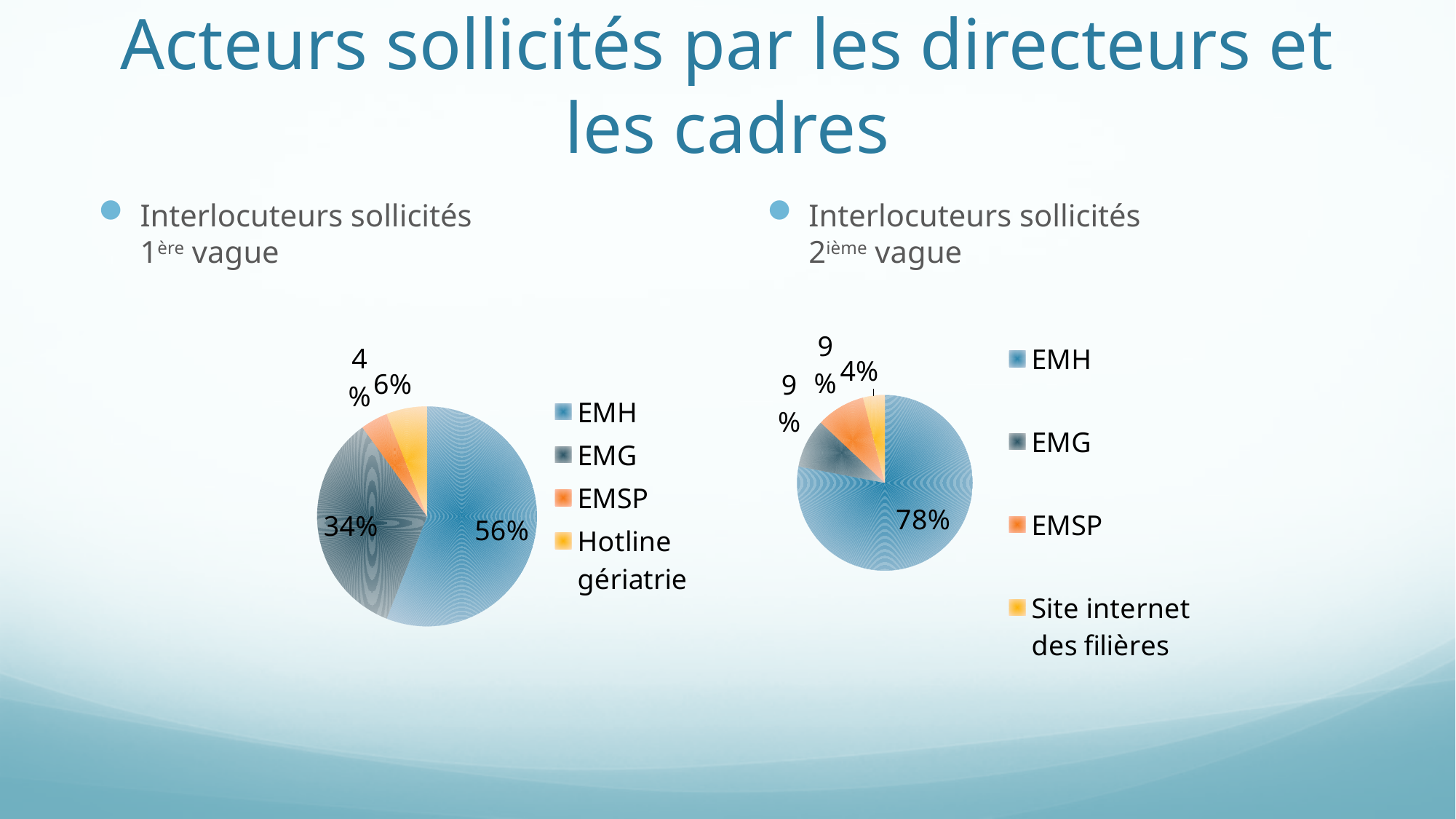
In the right chart (Interlocuteurs sollicités 2ième vague), what share does Site internet des filières have? 4% In the right chart (Interlocuteurs sollicités 2ième vague), what share does EMH have? 78% In the left chart (Interlocuteurs sollicités 1ère vague), what share does EMH have? 56% What type of chart is used on the right side of the slide (Interlocuteurs sollicités 2ième vague)? pie chart In the left chart (Interlocuteurs sollicités 1ère vague), what is the difference between the EMH and EMG shares? 22% In the left chart (Interlocuteurs sollicités 1ère vague), which category has the smallest slice? EMSP In the left chart (Interlocuteurs sollicités 1ère vague), how many categories does the legend list? 4 In the right chart (Interlocuteurs sollicités 2ième vague), which category has the largest slice? EMH In the left chart (Interlocuteurs sollicités 1ère vague), what share does EMG have? 34% In the left chart (Interlocuteurs sollicités 1ère vague), what share does Hotline gériatrie have? 6% In the right chart (Interlocuteurs sollicités 2ième vague), is the EMSP share larger or smaller than the Site internet des filières share? larger Which legend entry in the right chart (Interlocuteurs sollicités 2ième vague) is shown in yellow? Site internet des filières